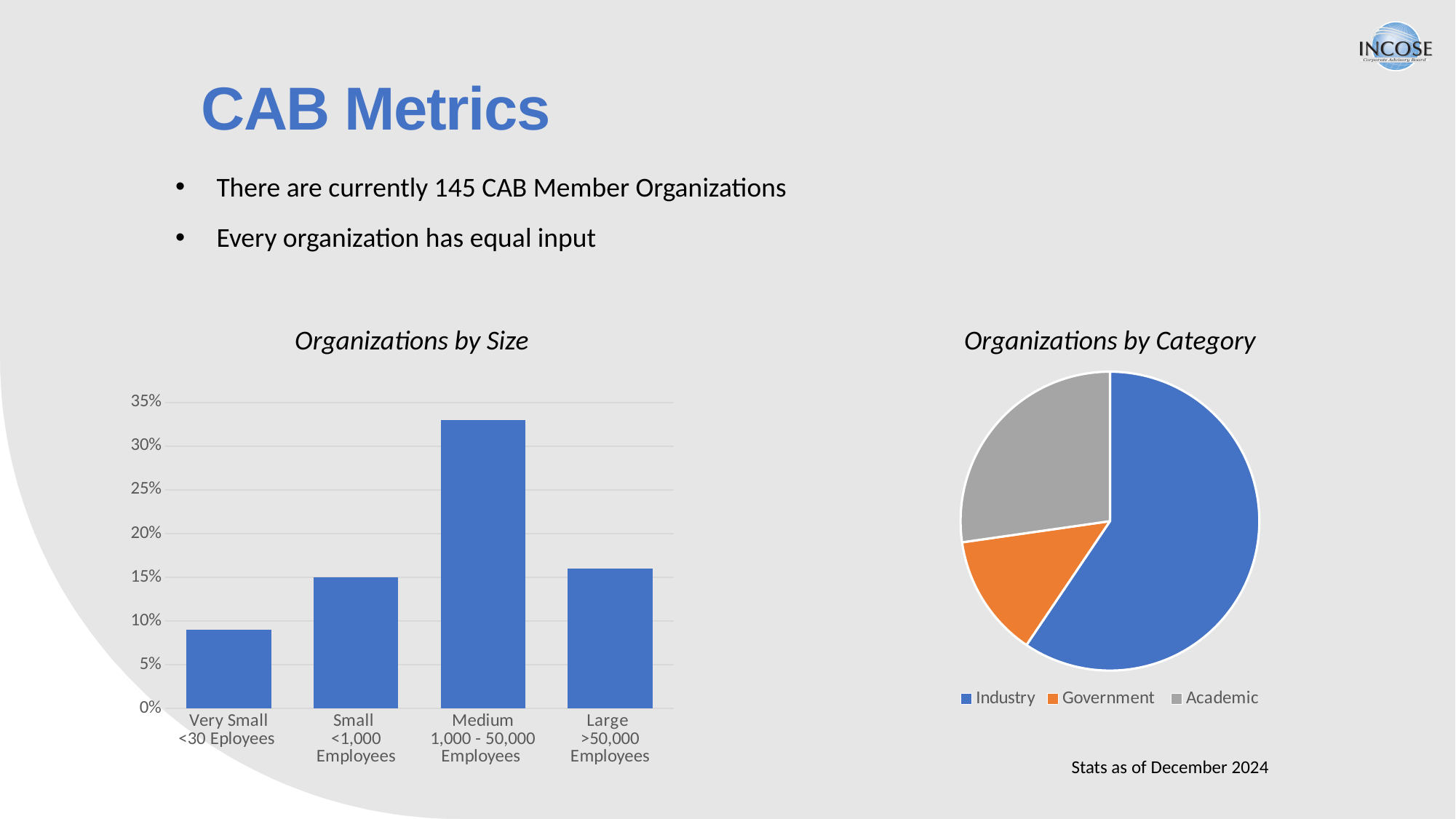
In the Organizations by Size chart, which is larger, the value for Medium or the value for Large? Medium What kind of chart is the Organizations by Size chart? Bar chart In the Organizations by Category chart, what colour is the Government slice? Orange In the Organizations by Category chart, how many categories does the legend list? 3 In the Organizations by Category chart, which category has the smallest slice? Government In the Organizations by Size chart, how many size categories are shown? 4 In the Organizations by Category chart, which category has the largest slice? Industry What kind of chart is the Organizations by Category chart? Pie chart In the Organizations by Size chart, which size category has the lowest value? Very Small (<30 Employees) In the Organizations by Size chart, is the value for Very Small greater or less than 10%? less In the Organizations by Size chart, is the value for Medium greater or less than 30%? greater In the Organizations by Size chart, which size category has the highest value? Medium (1,000 - 50,000 Employees)